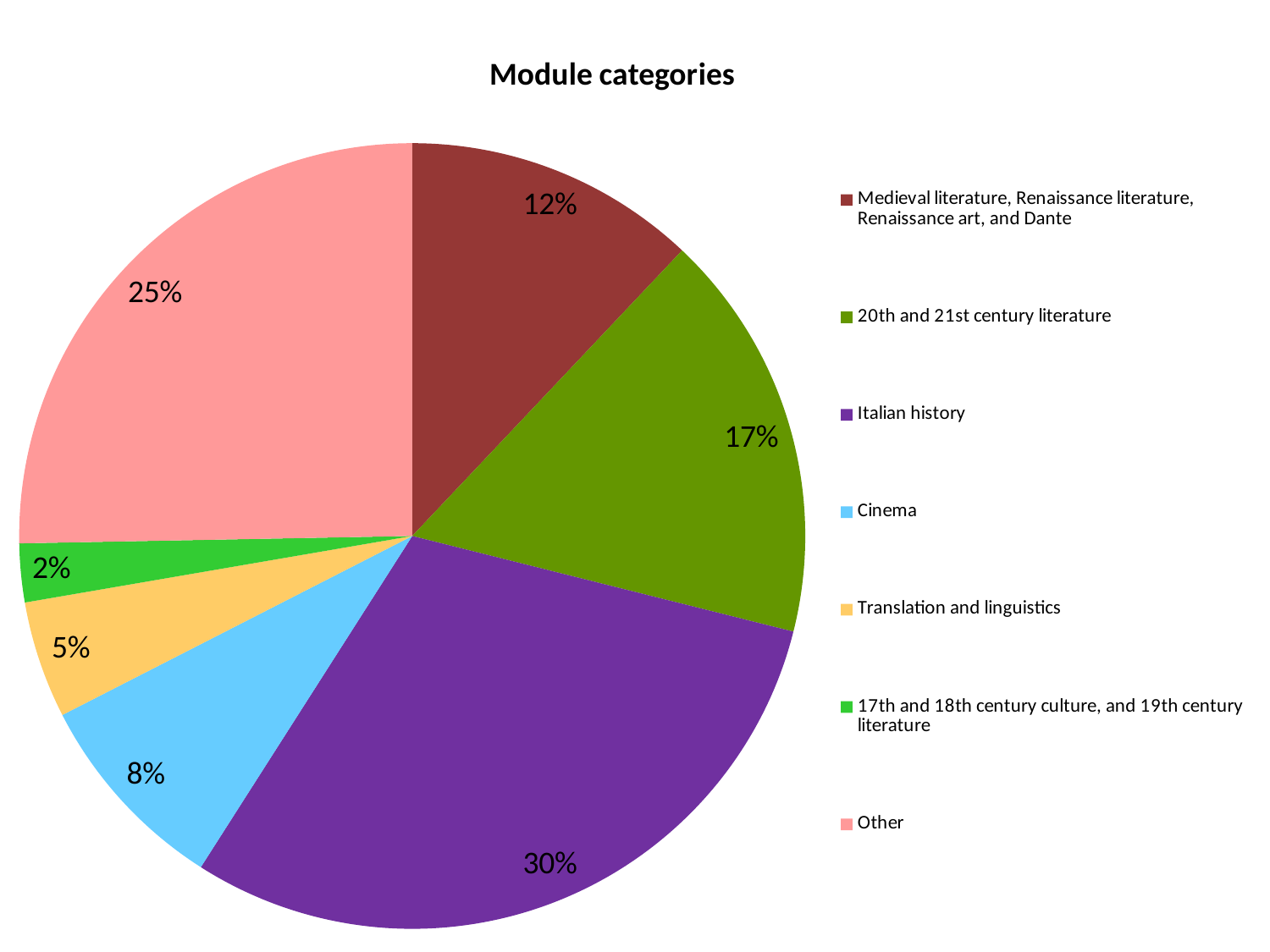
How many categories does the pie chart show? 7 Which category has the largest slice of the pie? Italian history What is the difference in percentage points between Italian history and Other? 5 What is the value for Translation and linguistics? 5% Which is larger, the slice for Cinema or the slice for Translation and linguistics? Cinema What is the title of the chart? Module categories What kind of chart is shown on the slide? Pie chart Which category has the smallest slice of the pie? 17th and 18th century culture, and 19th century literature What is the combined share of Medieval literature, Renaissance literature, Renaissance art, and Dante and 20th and 21st century literature? 29% What percentage is shown for 20th and 21st century literature? 17% What share of the pie does Italian history take? 30% What is the value shown for Cinema? 8%